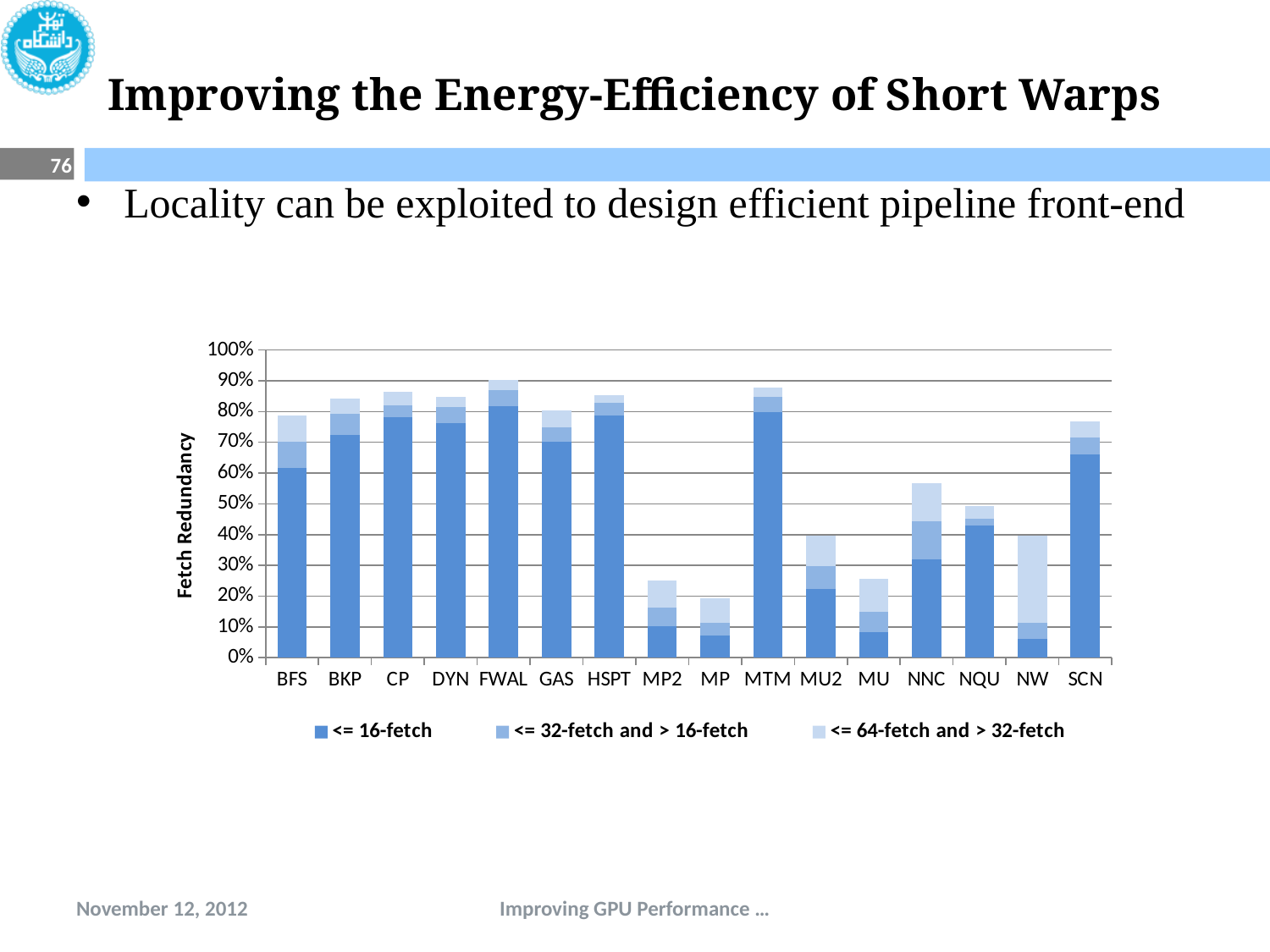
Which benchmark has the lowest total fetch redundancy in the chart? MP Is the total fetch redundancy for MP greater or less than 30%? less Is the total fetch redundancy for CP greater or less than 80%? greater Is the total fetch redundancy for BFS greater or less than 70%? greater Which has the larger total fetch redundancy, MP2 or NNC? NNC How many categories (benchmarks) are shown on the x axis of the chart? 16 What is the first series listed in the chart's legend? <= 16-fetch How many series does the chart's legend list? 3 Which has the larger total fetch redundancy, BKP or MU2? BKP What is the label of the y axis of the chart? Fetch Redundancy What kind of chart is shown on the slide? stacked bar chart